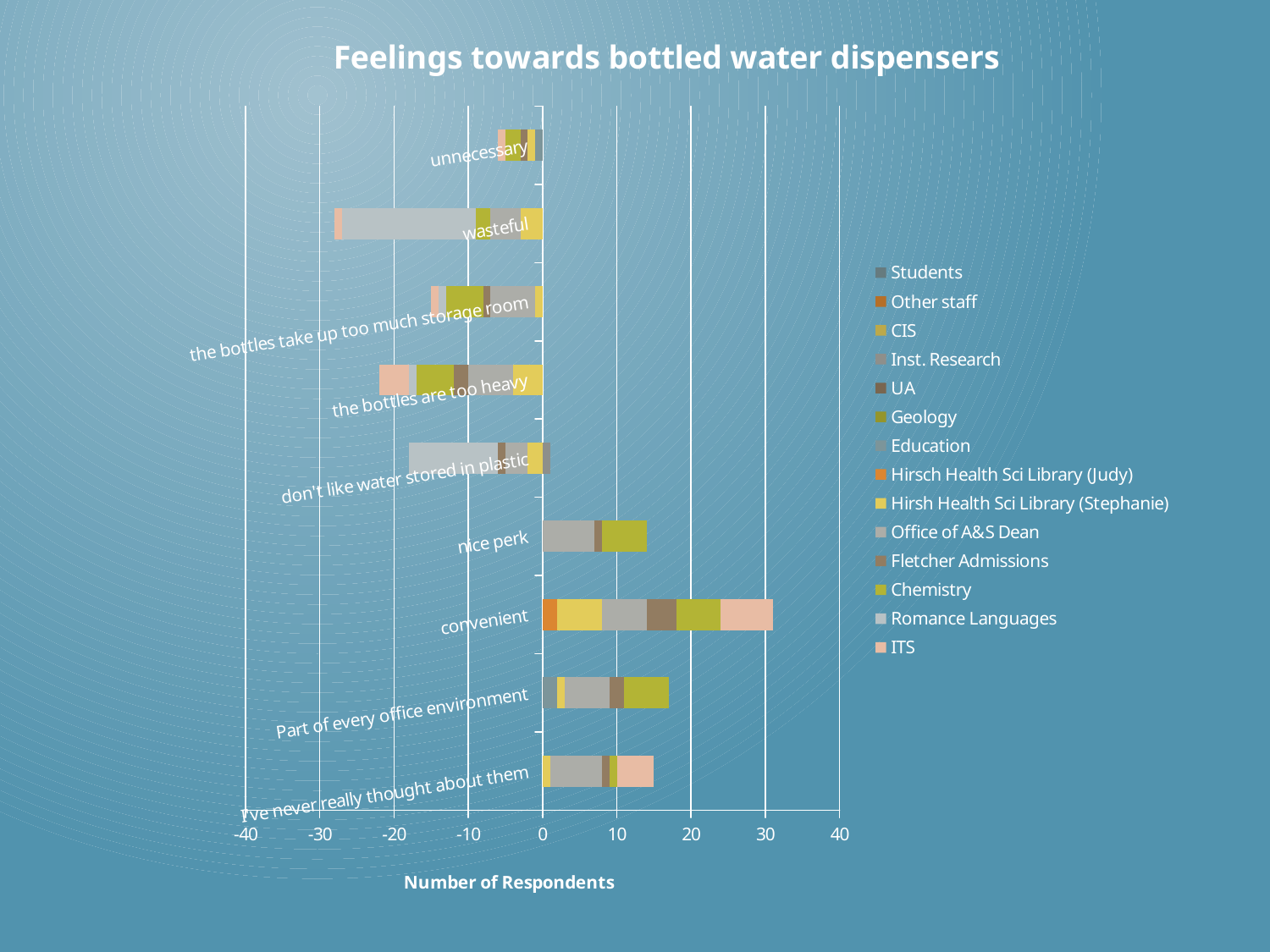
How many categories (feelings) are plotted on the chart? 9 What is the label on the horizontal axis? Number of Respondents What kind of chart is shown on the slide? bar chart Which category has the longest bar extending to the right (positive side)? convenient Which bar is longer, 'convenient' or 'nice perk'? convenient How many series does the legend list? 14 Is the total bar length for 'Part of every office environment' greater or less than 20? less Which category has the longest bar extending to the left (negative side)? wasteful Is the total bar length for 'convenient' greater or less than 20? greater Is the total bar length for 'nice perk' greater or less than 10? greater What is the title of the chart? Feelings towards bottled water dispensers Which category has the shortest bar overall? unnecessary